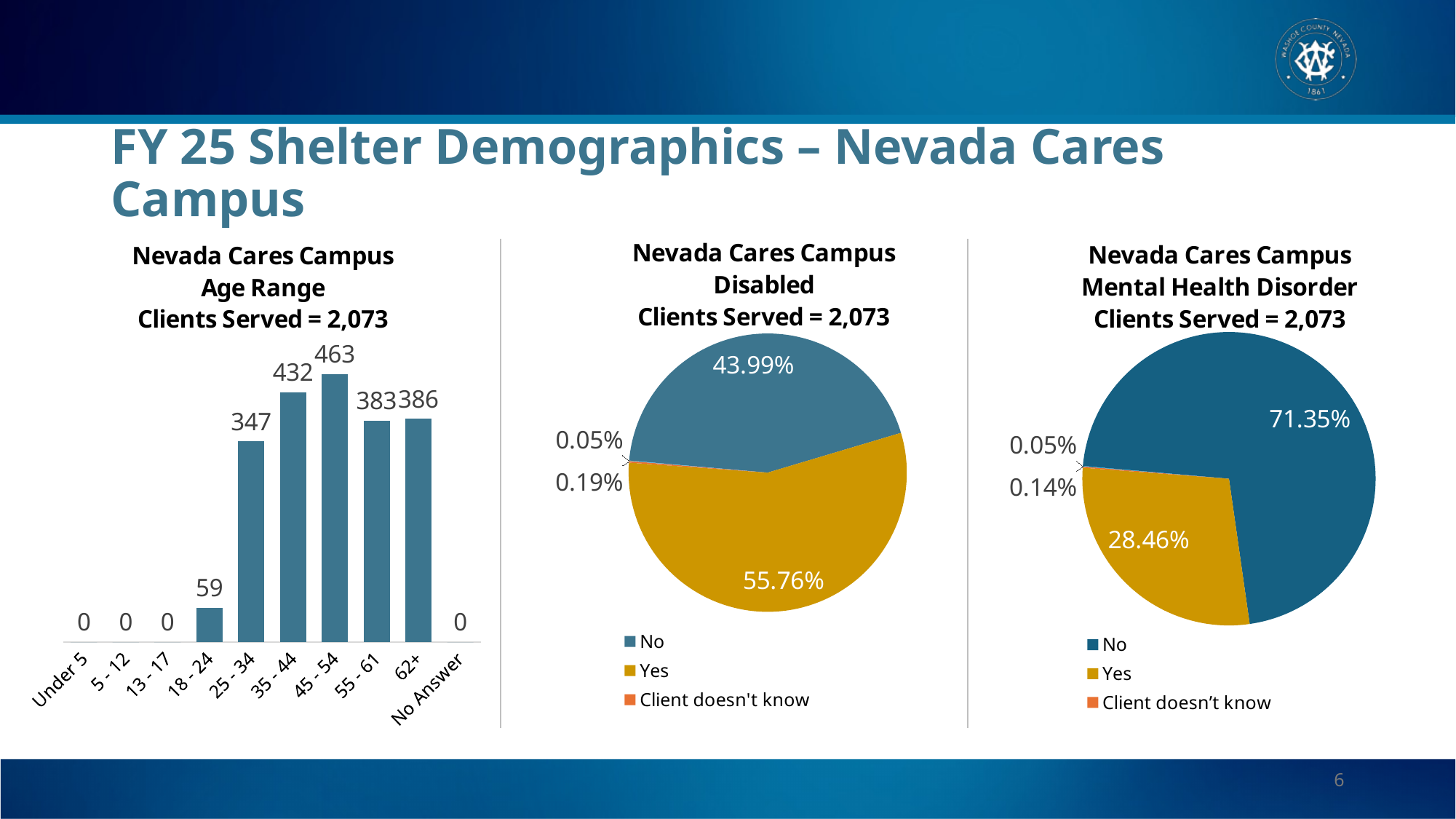
In the Nevada Cares Campus Age Range chart, how many clients were in the 18 - 24 age range? 59 In the Nevada Cares Campus Disabled pie chart, what percentage of clients answered No? 43.99% In the Nevada Cares Campus Age Range chart, how many clients were in the 45 - 54 age range? 463 In the Nevada Cares Campus Mental Health Disorder pie chart, what percentage of clients answered Yes? 28.46% In the Nevada Cares Campus Age Range chart, what is the difference between the 45 - 54 and 35 - 44 values? 31 In the Nevada Cares Campus Age Range chart, how many age range categories are shown on the x axis? 10 In the Nevada Cares Campus Mental Health Disorder pie chart, what percentage of clients answered No? 71.35% In the Nevada Cares Campus Age Range chart, which has more clients, 62+ or 55 - 61? 62+ What type of chart is the Nevada Cares Campus Age Range chart? Bar chart In the Nevada Cares Campus Age Range chart, which age range has the highest number of clients? 45 - 54 How many entries does the legend of the Nevada Cares Campus Mental Health Disorder pie chart list? 3